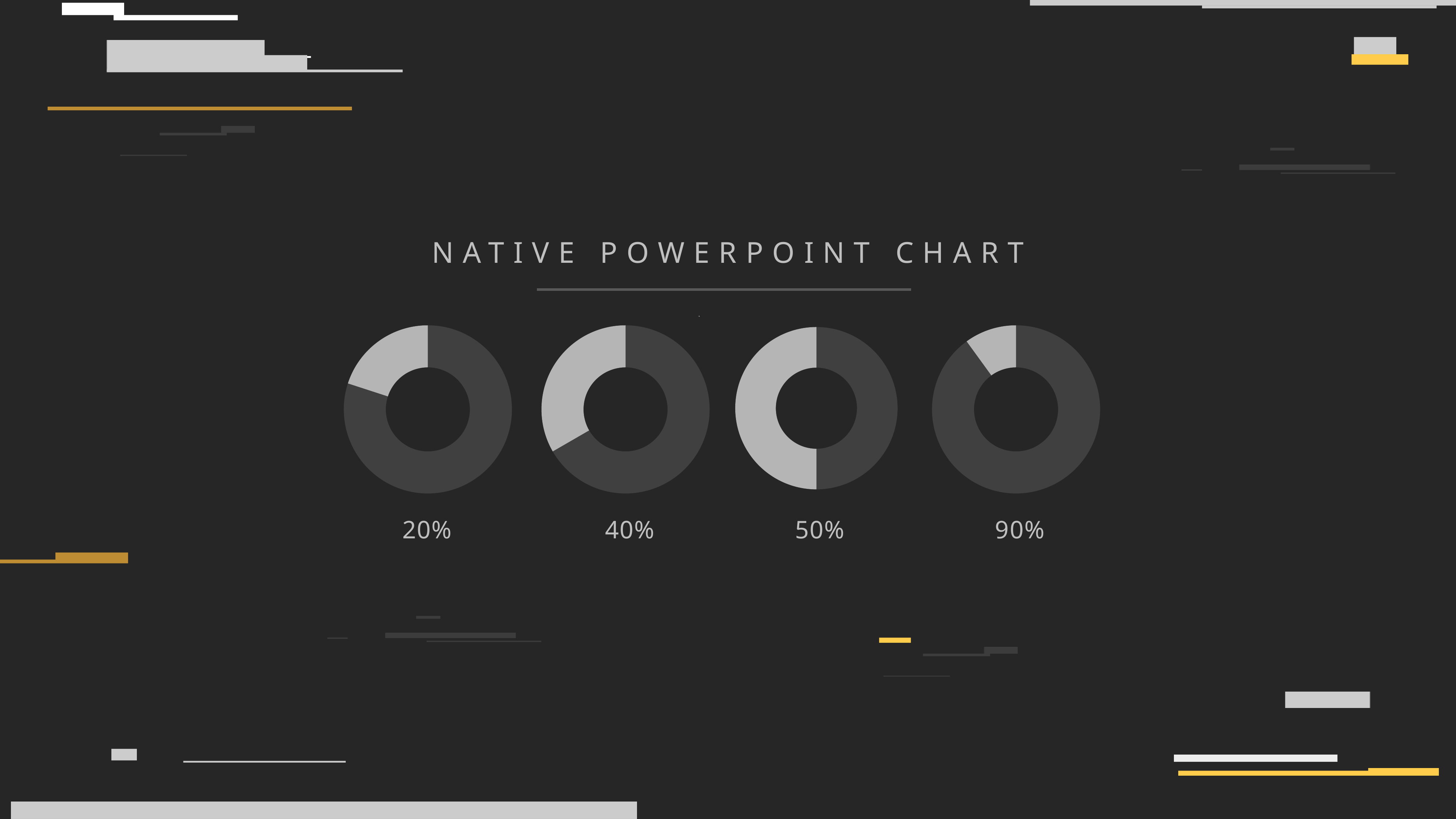
What is the difference between the value of the rightmost doughnut chart and the leftmost doughnut chart? 70% How many doughnut charts are shown on the slide? 4 Which doughnut chart has the highest printed value? The rightmost chart (90%) What value is printed below the leftmost doughnut chart? 20% What value is printed below the second doughnut chart from the left? 40% What value is printed below the rightmost doughnut chart? 90% What is the title shown above the doughnut charts? NATIVE POWERPOINT CHART What kind of charts are shown on the slide? Doughnut (pie) charts What value is printed below the third doughnut chart from the left? 50% What is the difference between the values of the third and second doughnut charts from the left? 10% Which doughnut chart has the lowest printed value? The leftmost chart (20%) Which is larger, the value of the second doughnut chart from the left or the third? The third (50%)